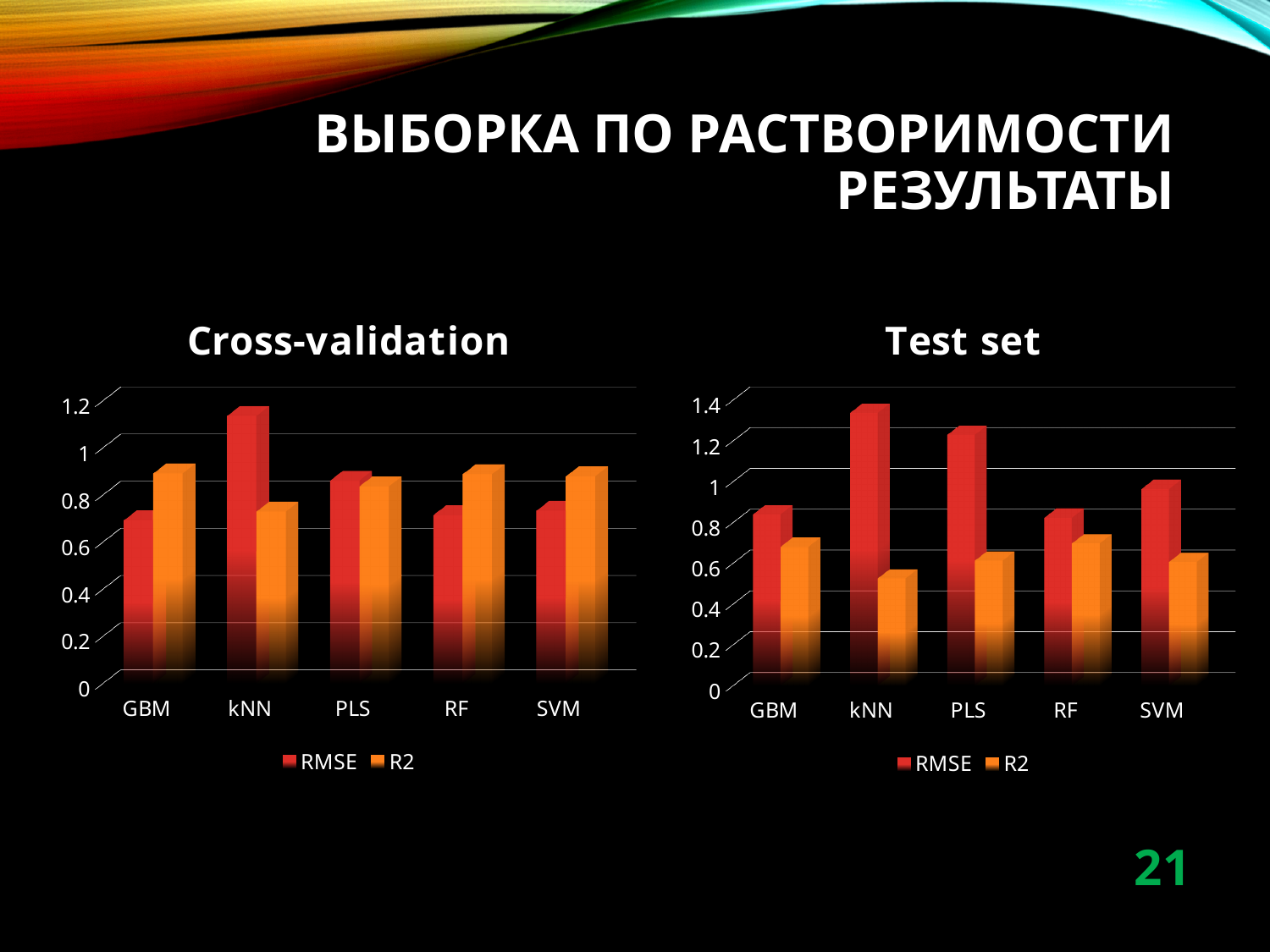
What type of chart is the Cross-validation chart? bar chart What are the two series named in the legend of the Test set chart? RMSE and R2 In the Test set chart, is the RMSE value for kNN greater or less than 1.2? greater In the Cross-validation chart, which category has the highest RMSE value? kNN How many categories are shown on the x axis of the Test set chart? 5 In the Test set chart, is the RMSE value for PLS greater or less than 1? greater In the Cross-validation chart, is the RMSE value for kNN greater or less than 1? greater In the Test set chart, which category has the lowest R2 value? kNN How many series does the legend of the Cross-validation chart list? 2 In the Test set chart, which category has the highest RMSE value? kNN In the Cross-validation chart, which is larger for kNN: RMSE or R2? RMSE